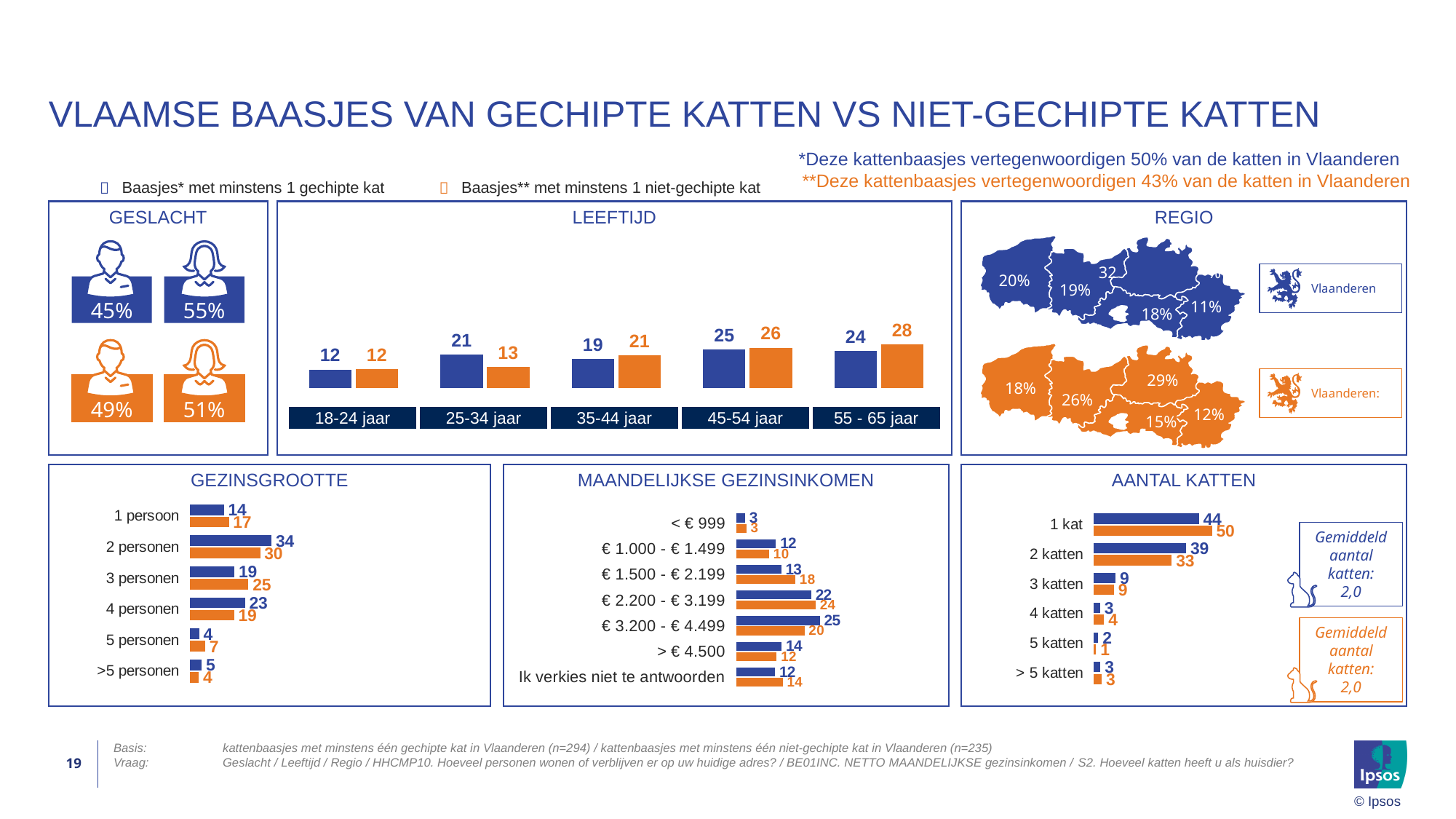
In the MAANDELIJKSE GEZINSINKOMEN chart, how many income categories are listed? 7 In the GEZINSGROOTTE chart, which category has the lowest value in the orange series? >5 personen In the GEZINSGROOTTE chart, what kind of chart is used? Bar chart In the LEEFTIJD chart, which age group has the highest value in the blue series (baasjes met minstens 1 gechipte kat)? 45-54 jaar In the MAANDELIJKSE GEZINSINKOMEN chart, which income category has the highest blue value? € 3.200 - € 4.499 In the GEZINSGROOTTE chart, what is the blue value for 2 personen? 34 How many series does the legend at the top of the slide list? 2 In the LEEFTIJD chart, how many age groups are shown on the x axis? 5 In the LEEFTIJD chart, what is the value for the 55 - 65 jaar group in the orange series (baasjes met minstens 1 niet-gechipte kat)? 28 In the AANTAL KATTEN chart, which is larger for 2 katten: the blue value or the orange value? Blue (39) In the MAANDELIJKSE GEZINSINKOMEN chart, what is the orange value for € 2.200 - € 3.199? 24 In the LEEFTIJD chart, what is the difference between the orange and blue values for the 25-34 jaar group? 8